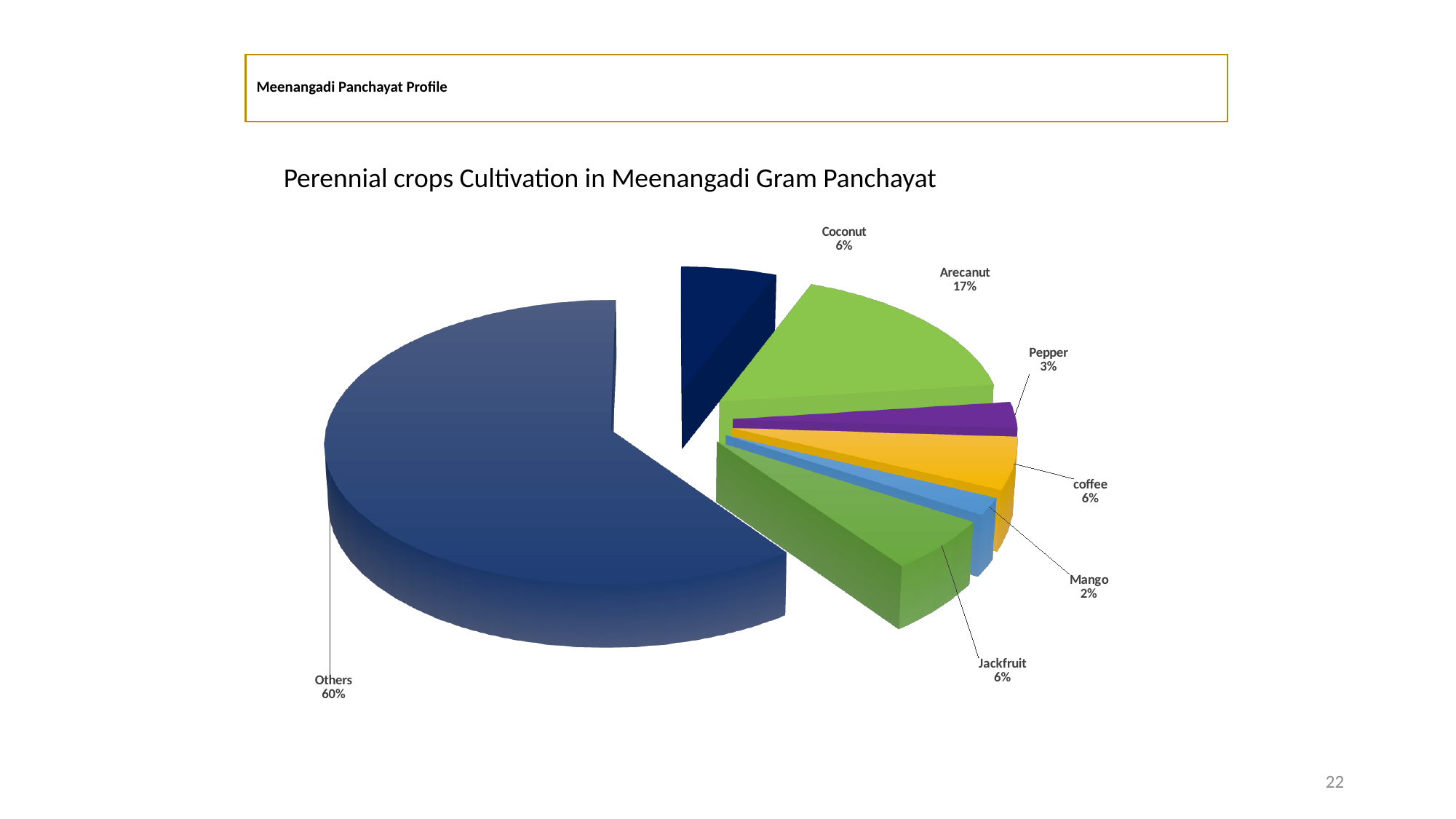
Which category has the smallest slice of the pie? Mango What share of the pie does Others represent? 60% What is the value shown for Mango? 2% Which is larger, the share for Arecanut or the share for Coconut? Arecanut What is the difference between the Pepper share and the Mango share? 1% Which category has the largest slice of the pie? Others What is the title of the chart? Perennial crops Cultivation in Meenangadi Gram Panchayat What is the value shown for Pepper? 3% What kind of chart is shown on the slide? Pie chart What is the value shown for Arecanut? 17% How many categories are shown in the pie chart? 7 What is the difference between the Others share and the Arecanut share? 43%